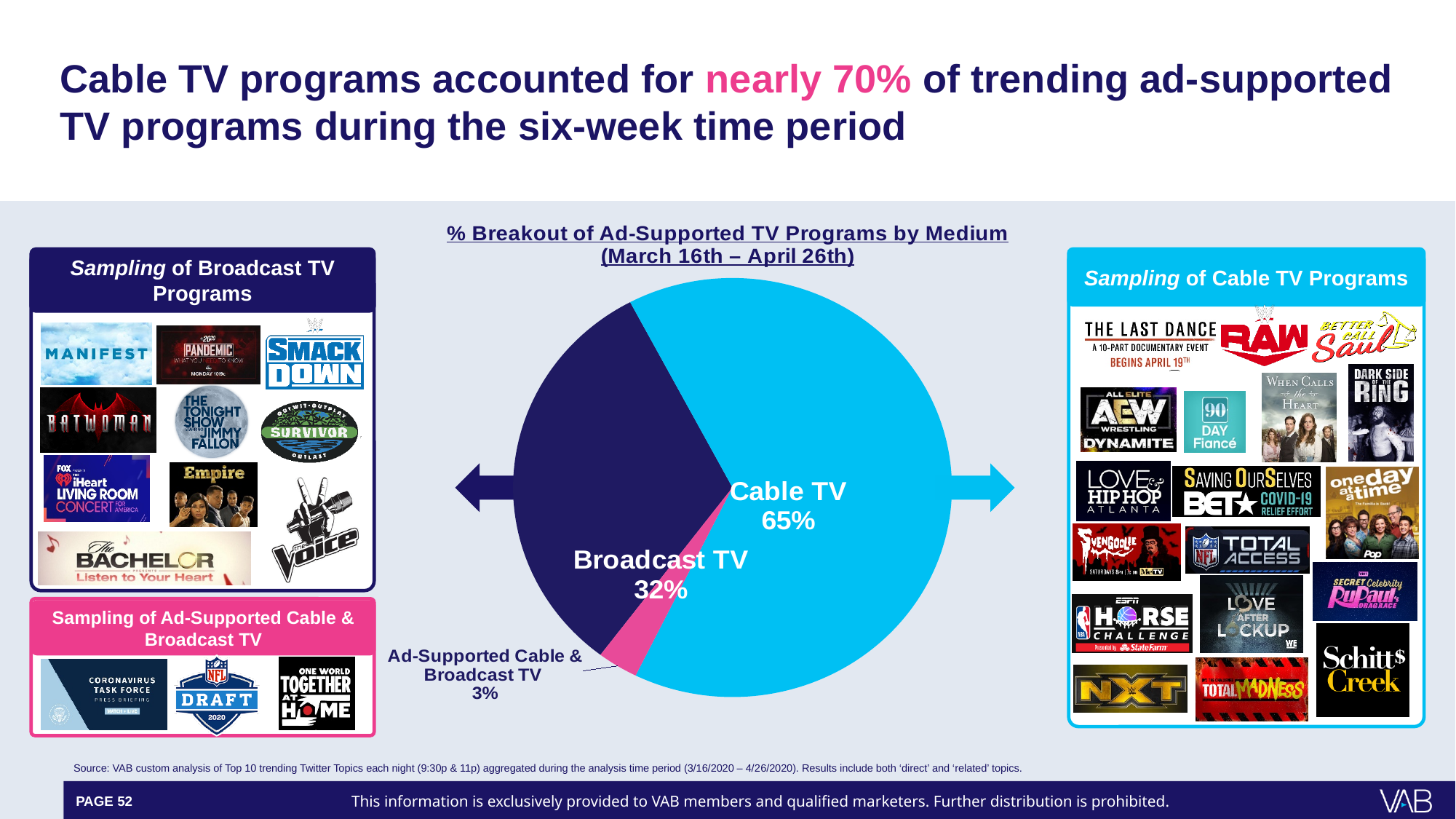
Which medium has the smallest slice of the pie chart? Ad-Supported Cable & Broadcast TV What type of chart is shown on the slide? Pie chart What is the difference in percentage points between the Cable TV and Broadcast TV slices? 33 What is the title of the pie chart? % Breakout of Ad-Supported TV Programs by Medium (March 16th – April 26th) Which medium has the largest slice of the pie chart? Cable TV What share of ad-supported TV programs does Cable TV account for in the pie chart? 65% What share of ad-supported TV programs does Broadcast TV account for in the pie chart? 32% What share does the Ad-Supported Cable & Broadcast TV slice represent? 3% How many slices does the pie chart have? 3 What is the combined share of the Broadcast TV and Ad-Supported Cable & Broadcast TV slices? 35% Which slice is larger, Broadcast TV or Ad-Supported Cable & Broadcast TV? Broadcast TV What colour is the Cable TV slice of the pie chart? Light blue